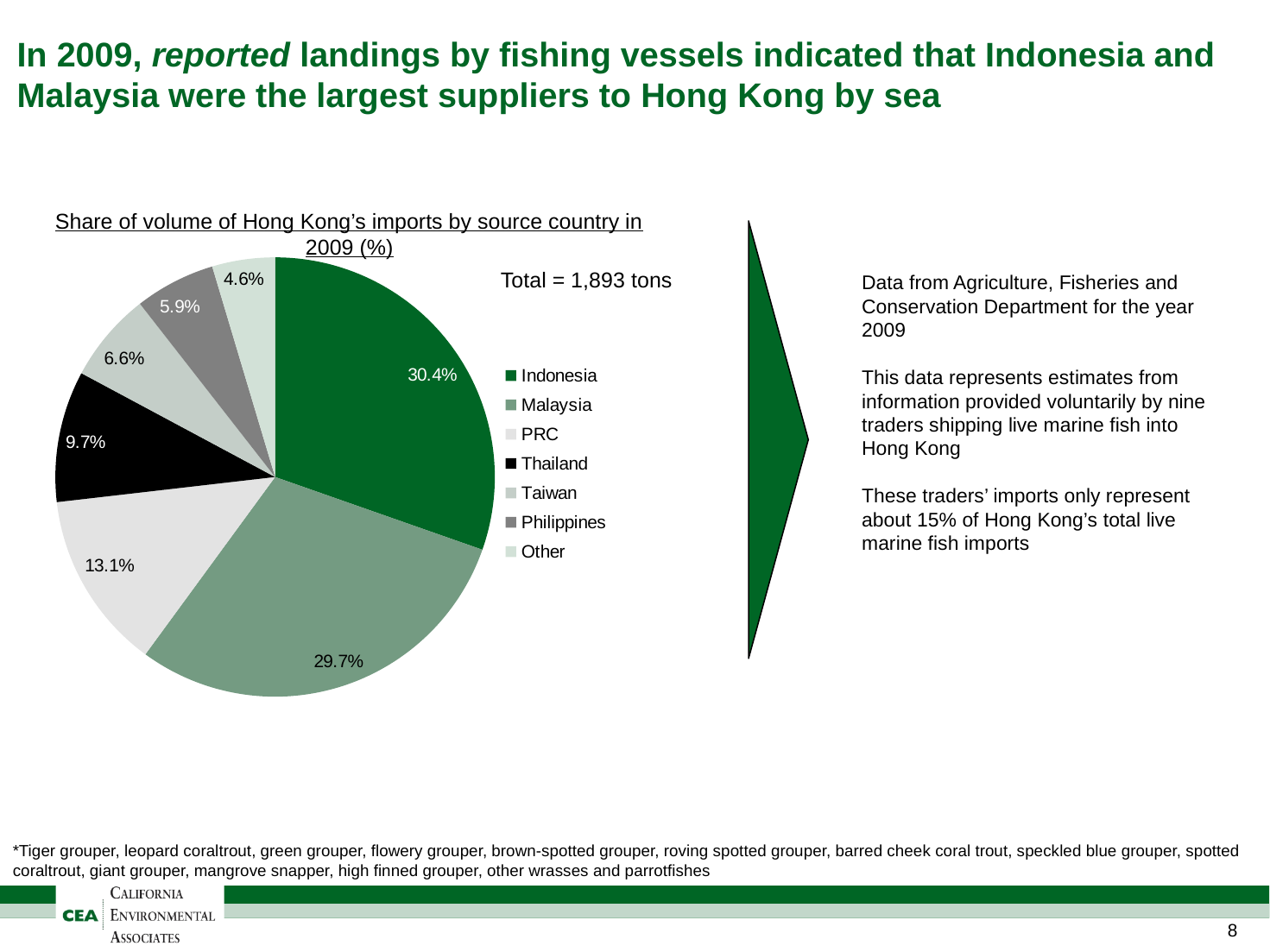
What share of Hong Kong's import volume in 2009 came from Indonesia? 30.4% What share of Hong Kong's import volume in 2009 came from Thailand? 9.7% What is the difference in percentage points between the shares of Indonesia and Malaysia? 0.7 Which category has the smallest share in the pie chart? Other Which has a larger share, Taiwan or Thailand? Thailand What type of chart is shown on the slide? pie chart What total volume in tons is stated next to the pie chart? 1,893 tons How many categories does the legend of the pie chart list? 7 What share of Hong Kong's import volume in 2009 came from the Philippines? 5.9% What share of Hong Kong's import volume in 2009 came from PRC? 13.1% What share of Hong Kong's import volume in 2009 came from Malaysia? 29.7% Which source country has the largest share of Hong Kong's import volume in 2009? Indonesia